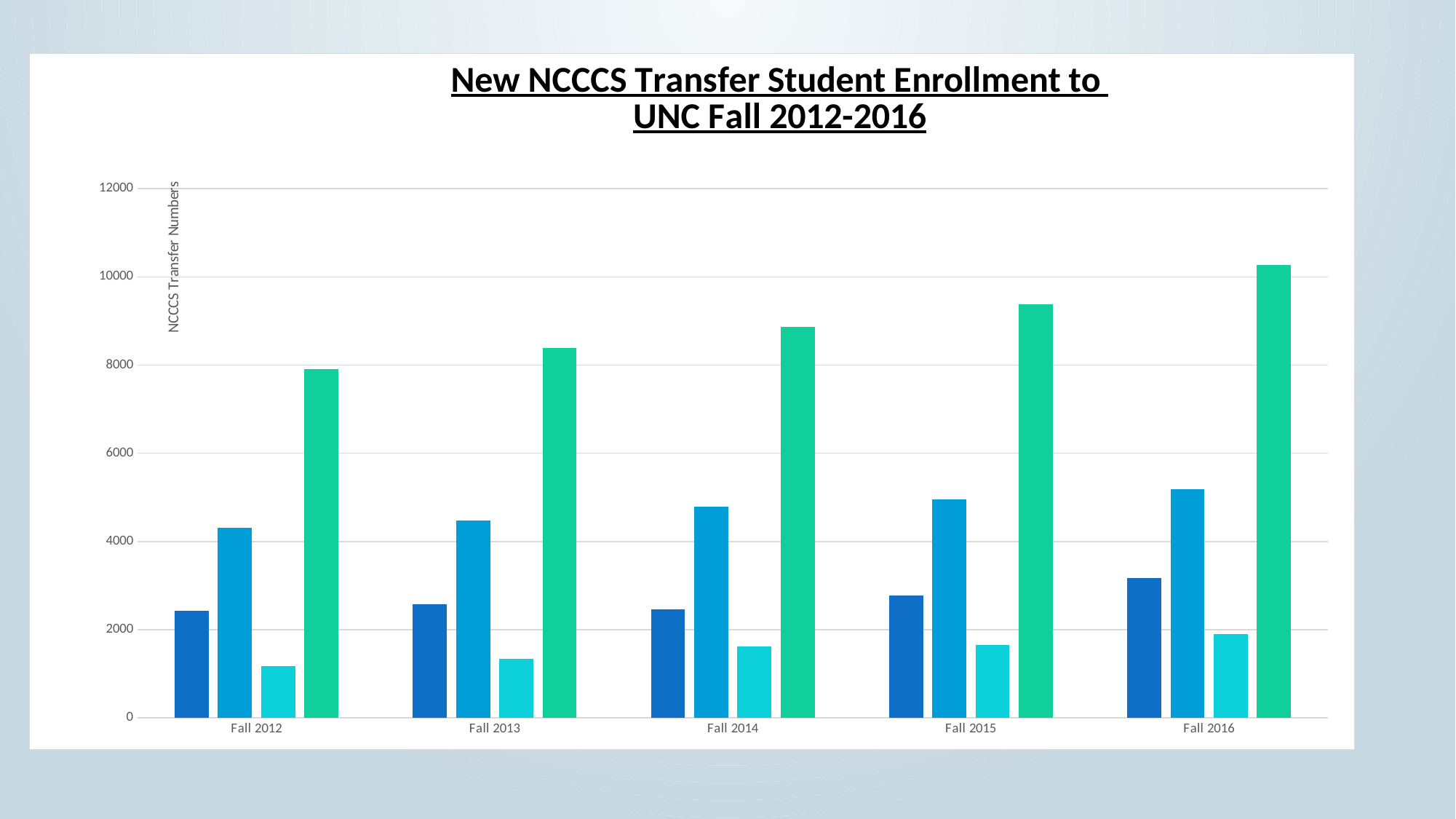
Is the value of the dark blue bar for Fall 2016 greater or less than 2000? greater How many categories (fall terms) are shown on the x axis? 5 In which fall term is the green bar the tallest? Fall 2016 In Fall 2012, which is larger: the green bar or the dark blue bar? the green bar Do the green bars rise or fall from Fall 2012 to Fall 2016? rise Is the value of the green bar for Fall 2015 greater or less than 8000? greater Is the value of the light blue (cyan) bar for Fall 2012 greater or less than 2000? less How many bars are plotted for each fall term? 4 What is the title of the chart? New NCCCS Transfer Student Enrollment to UNC Fall 2012-2016 What kind of chart is shown on the slide? bar chart What is the label on the vertical axis? NCCCS Transfer Numbers